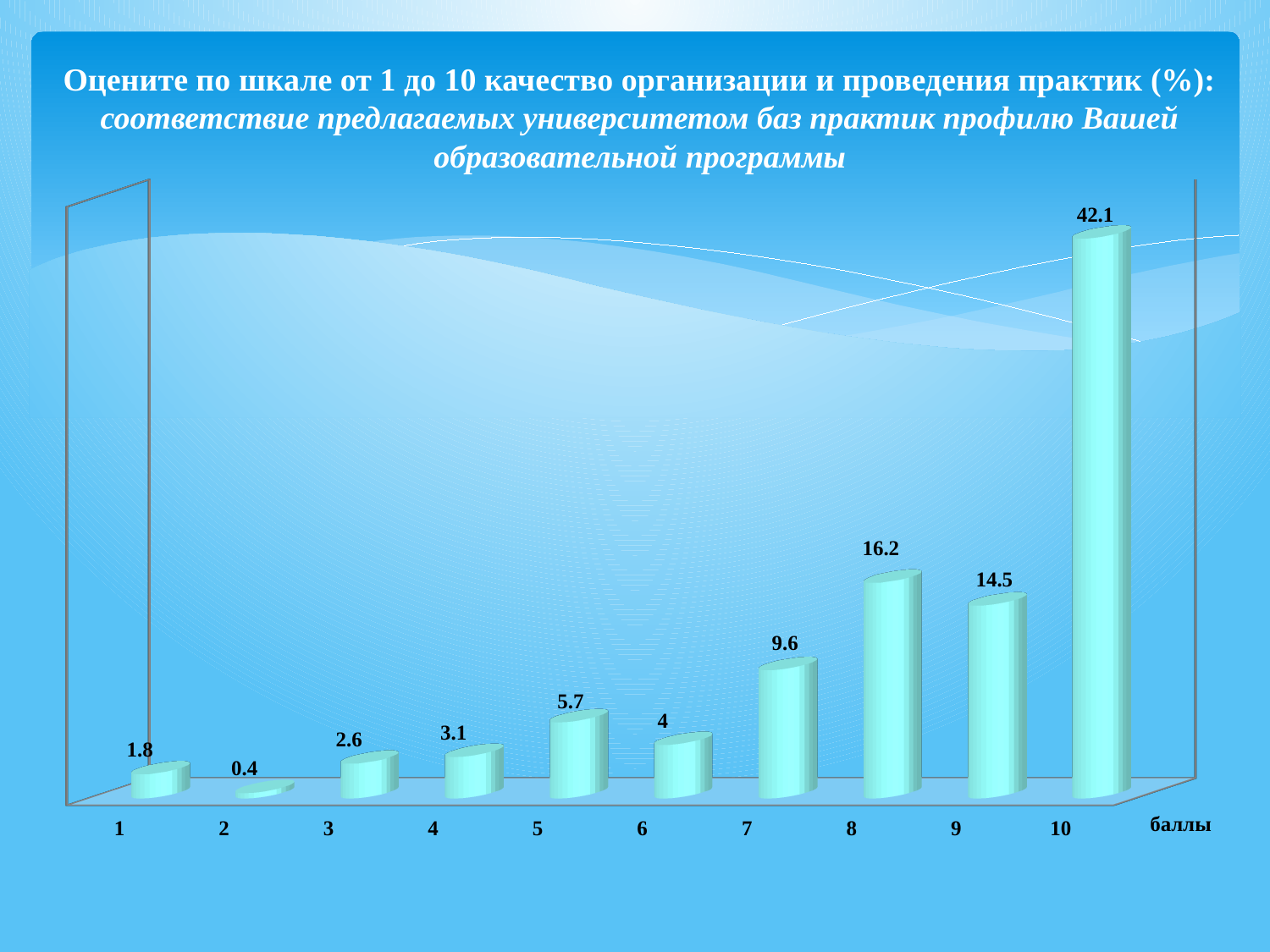
Does the value for score 6 fall below the value for score 5? yes Which score has the highest value? 10 What kind of chart is shown on the slide? bar chart What label is shown at the end of the x axis? баллы What is the value for score 10? 42.1 Which score has the lowest value? 2 What is the value for score 5? 5.7 What is the difference between the values for score 8 and score 9? 1.7 How many score categories are shown on the x axis? 10 Which is larger, the value for score 5 or the value for score 6? score 5 What is the difference between the values for score 10 and score 8? 25.9 What is the value for score 2? 0.4